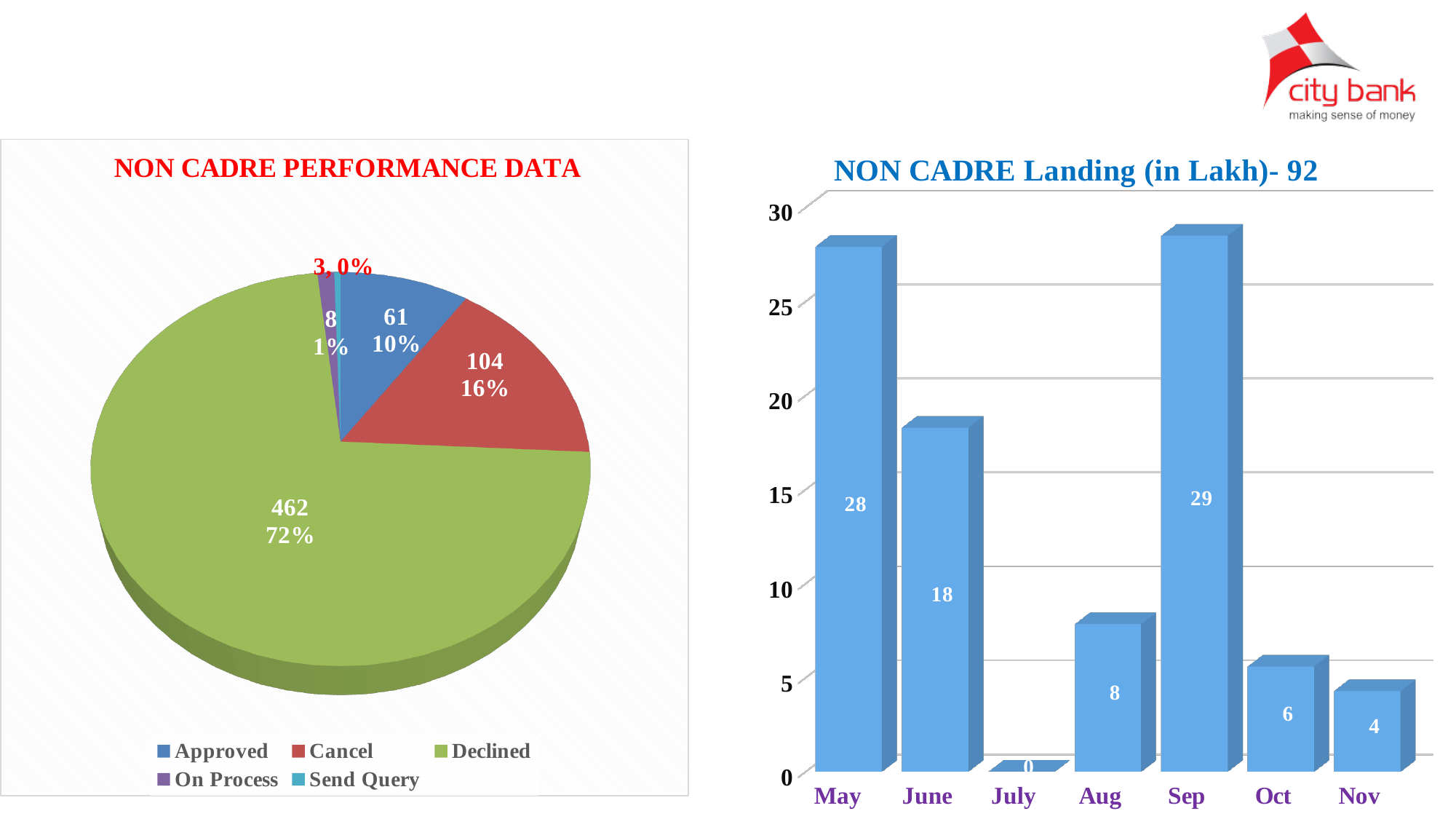
In the NON CADRE PERFORMANCE DATA chart, what value is shown for Declined? 462 In the NON CADRE PERFORMANCE DATA chart, which category has the largest slice? Declined In the NON CADRE Landing (in Lakh) chart, which month has the highest value? Sep What kind of chart is the NON CADRE Landing (in Lakh) chart? Bar chart How many categories does the legend of the NON CADRE PERFORMANCE DATA chart list? 5 What kind of chart is the NON CADRE PERFORMANCE DATA chart? Pie chart In the NON CADRE PERFORMANCE DATA chart, what is the difference between the Cancel and Approved values? 43 In the NON CADRE Landing (in Lakh) chart, which month has the lowest value? July In the NON CADRE PERFORMANCE DATA chart, which category has the smallest slice? Send Query In the NON CADRE Landing (in Lakh) chart, what is the value for June? 18 In the NON CADRE Landing (in Lakh) chart, is the value for Oct larger or smaller than the value for Aug? Smaller In the NON CADRE PERFORMANCE DATA chart, what percentage share does Cancel have? 16%